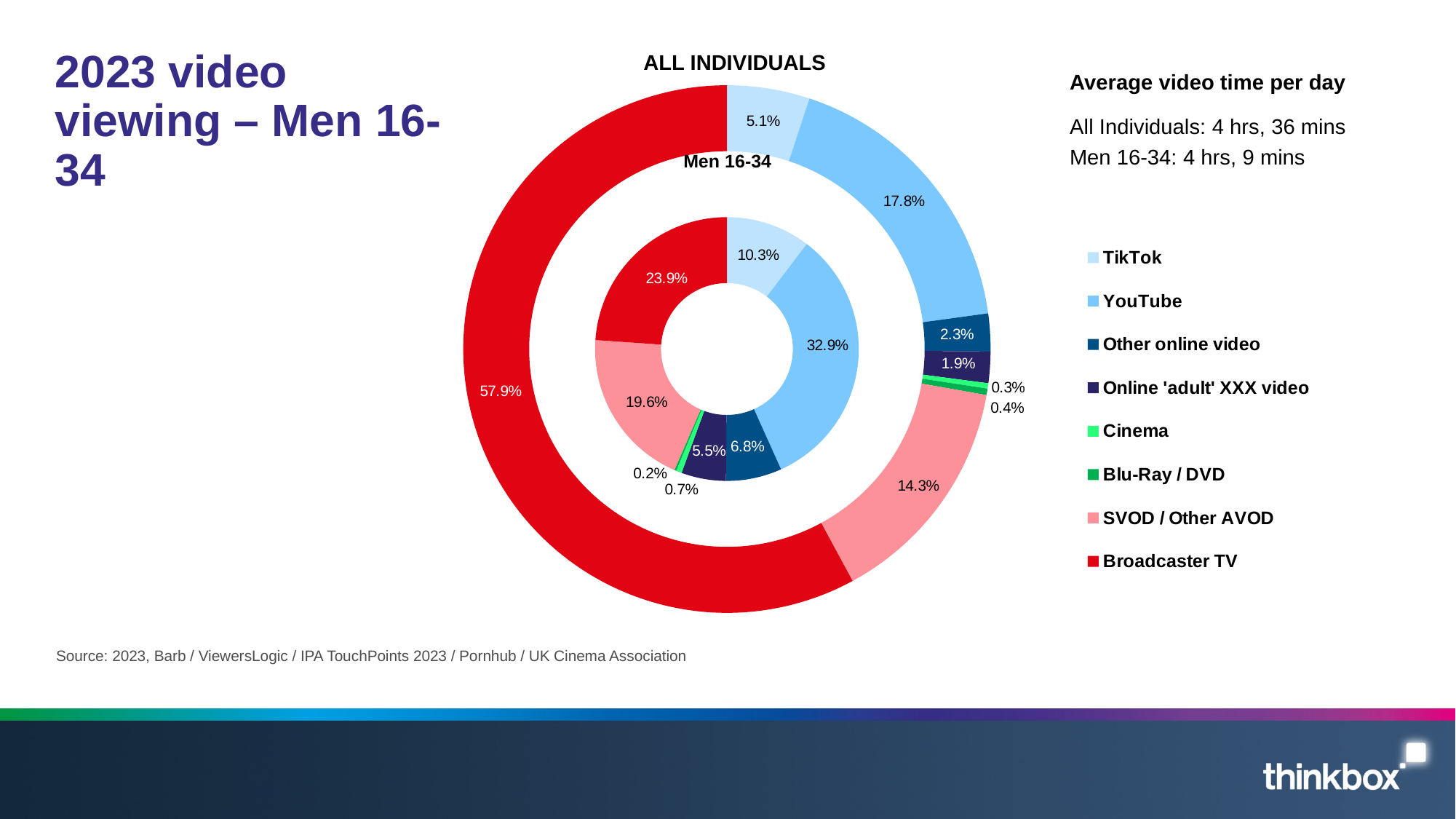
What kind of chart is shown on the slide? Doughnut chart In the ALL INDIVIDUALS ring, what share of video viewing is Broadcaster TV? 57.9% Which is larger: the YouTube share for Men 16-34 or the YouTube share for ALL INDIVIDUALS? Men 16-34 Which category has the largest share in the Men 16-34 ring? YouTube In the Men 16-34 ring, what share of video viewing is YouTube? 32.9% Which category has the largest share in the ALL INDIVIDUALS ring? Broadcaster TV In the ALL INDIVIDUALS ring, what share is SVOD / Other AVOD? 14.3% In the Men 16-34 ring, what share of video viewing is TikTok? 10.3% How many categories does the legend list? 8 According to the slide, what is the average video time per day for Men 16-34? 4 hrs, 9 mins What is the difference between the Other online video share for Men 16-34 and for ALL INDIVIDUALS? 4.5 percentage points What is the difference between the Broadcaster TV share for ALL INDIVIDUALS and for Men 16-34? 34 percentage points